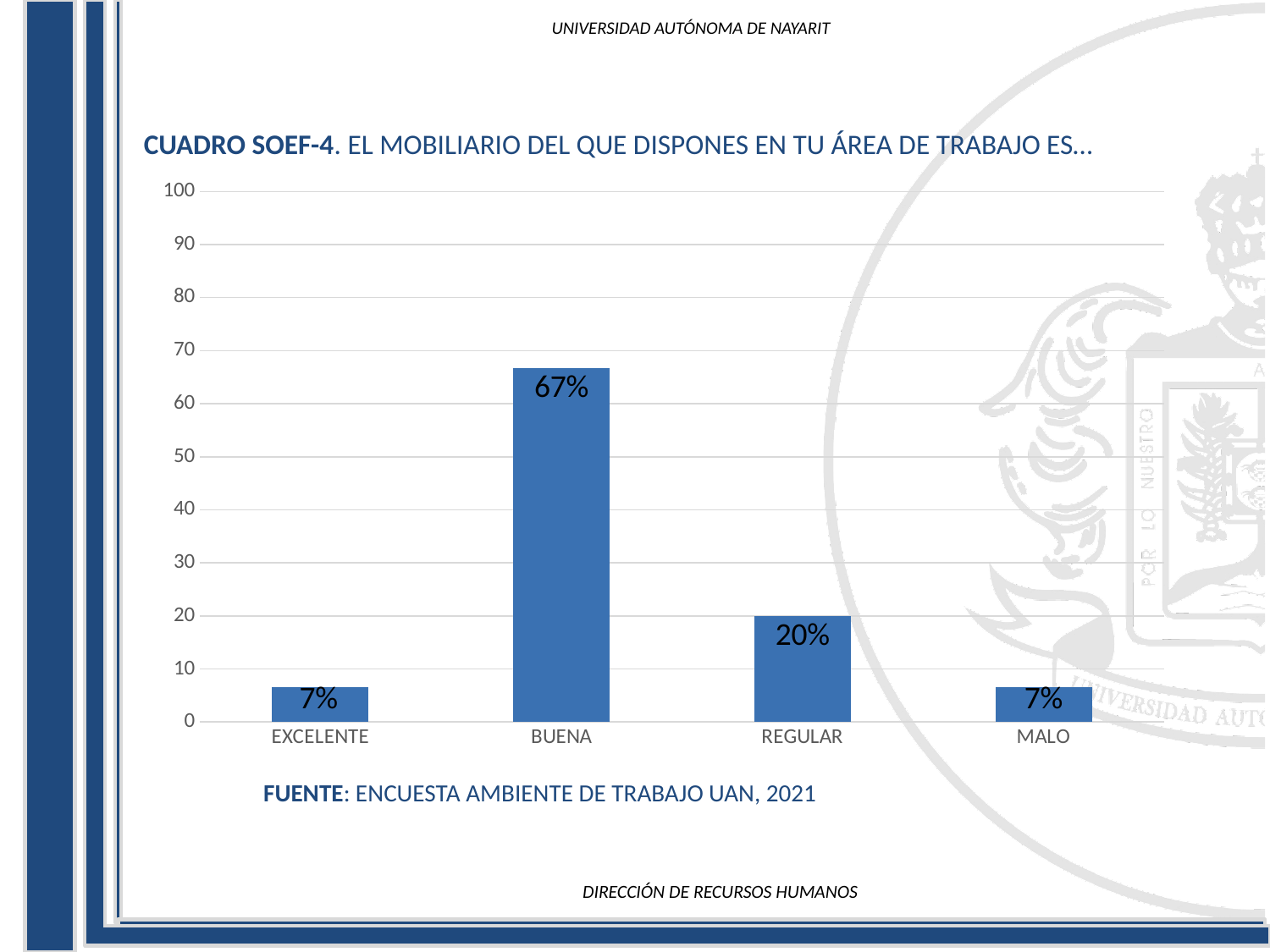
Which category has the highest value? BUENA What is the value for BUENA? 67% How many categories are shown on the x axis? 4 What is the difference between the values for BUENA and REGULAR? 47% Which is larger, the value for REGULAR or the value for EXCELENTE? REGULAR What is the value for REGULAR? 20% What is the value for MALO? 7% What is the value for EXCELENTE? 7% Is the value for BUENA greater or less than 60? greater What kind of chart is shown on the slide? bar chart What is the difference between the values for REGULAR and MALO? 13% What is the source cited below the chart? ENCUESTA AMBIENTE DE TRABAJO UAN, 2021